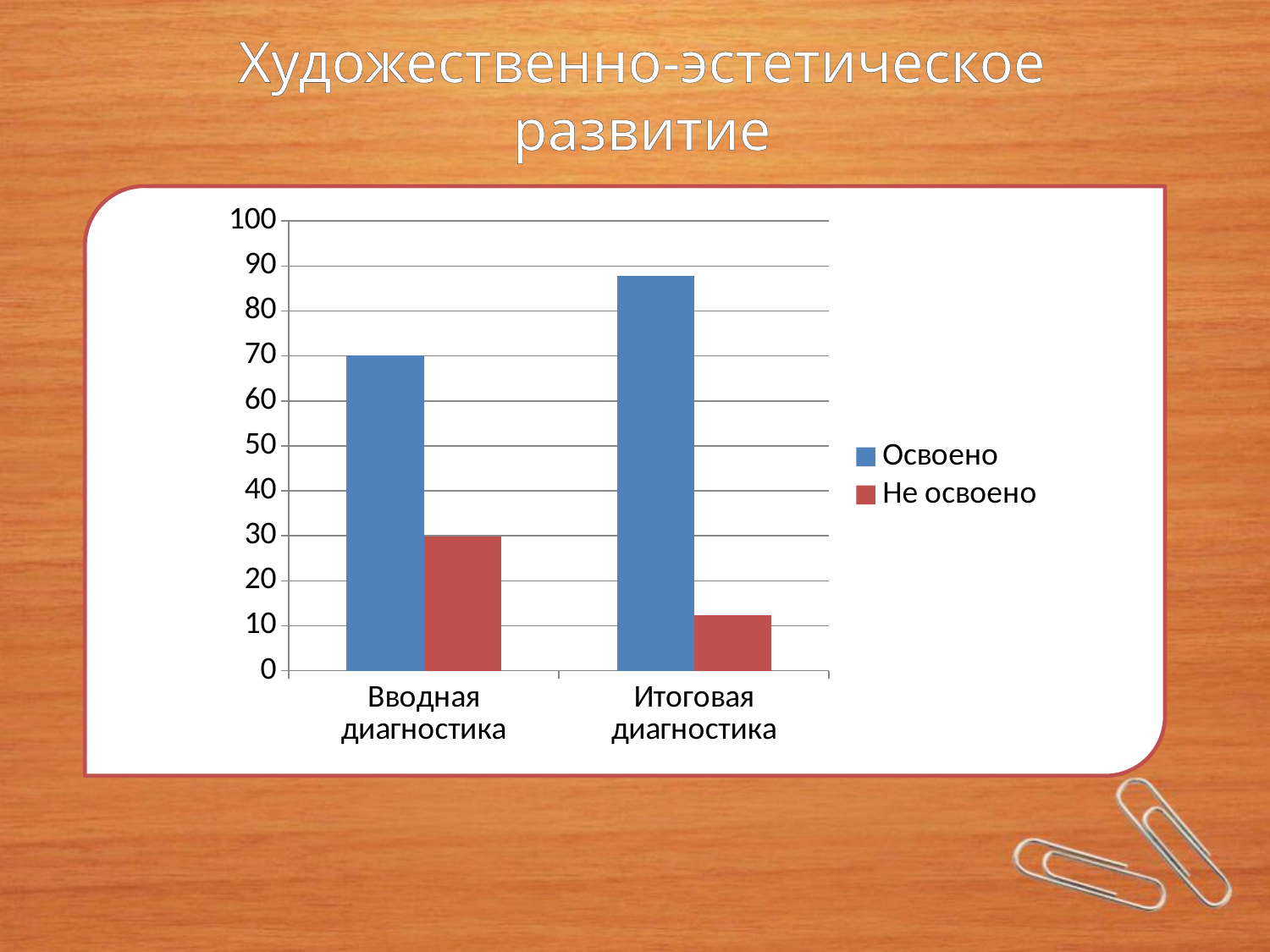
Which category has the higher value for Освоено? Итоговая диагностика How many categories are shown on the x axis? 2 Is the value of Не освоено for Итоговая диагностика greater or less than 20? less Is the value of Освоено for Итоговая диагностика greater or less than 80? greater Does the Освоено series rise or fall from Вводная диагностика to Итоговая диагностика? rise What type of chart is shown on the slide? bar chart What colour are the bars for the Не освоено series? red How many series does the legend list? 2 Which category has the lowest value for Не освоено? Итоговая диагностика